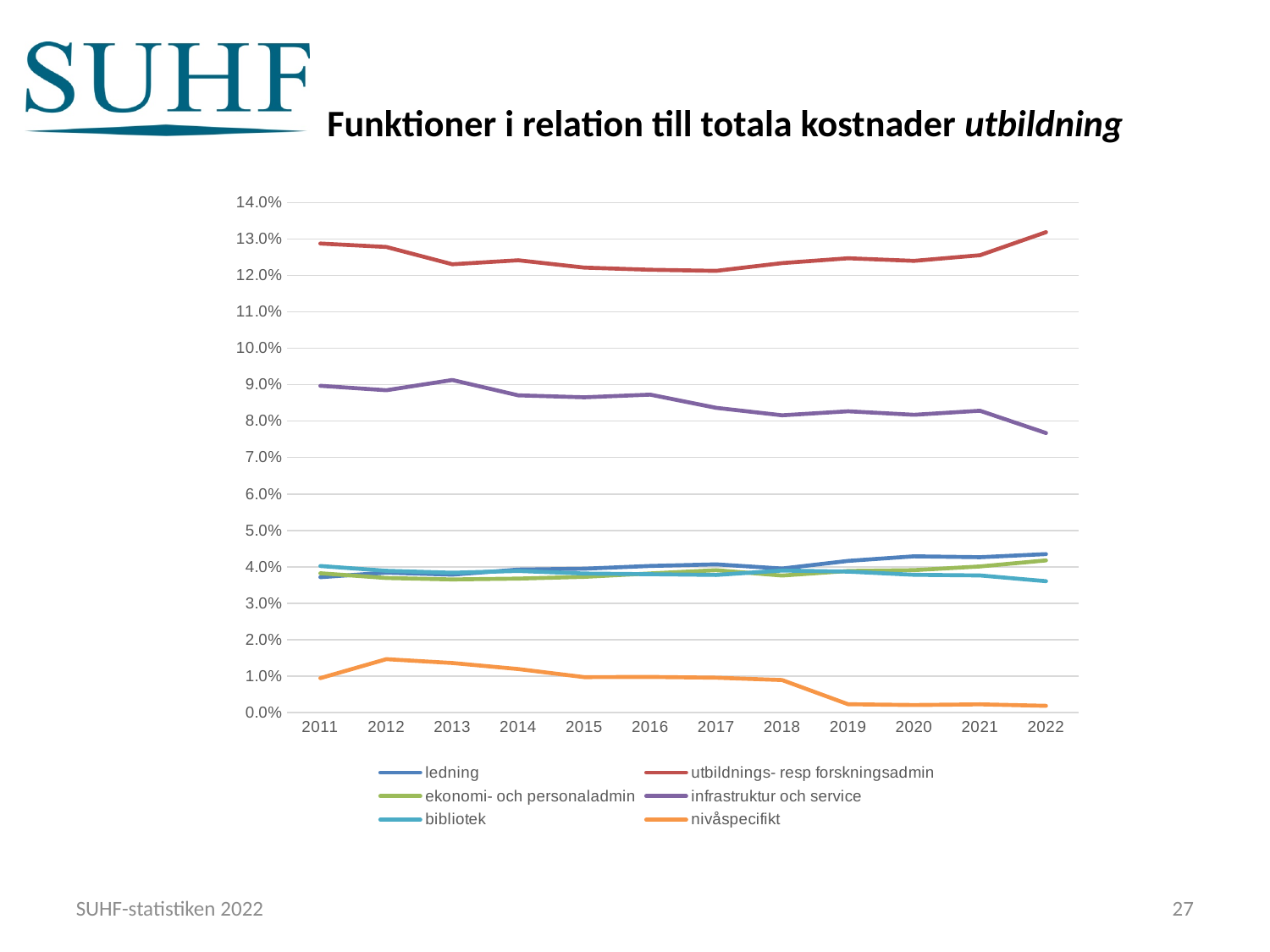
Does the infrastruktur och service series rise or fall from 2011 to 2022? fall Which series has the lowest values across all years? nivåspecifikt What is the title of the chart? Funktioner i relation till totala kostnader utbildning What kind of chart is shown on the slide? line chart How many series does the legend list? 6 How many years are shown on the x axis? 12 Is the value for utbildnings- resp forskningsadmin in 2022 greater or less than 12.0%? greater In 2022, which is larger: ledning or bibliotek? ledning Is the value for nivåspecifikt in 2012 greater or less than 1.0%? greater Which series has the highest values across all years? utbildnings- resp forskningsadmin Is the value for nivåspecifikt in 2019 greater or less than 1.0%? less